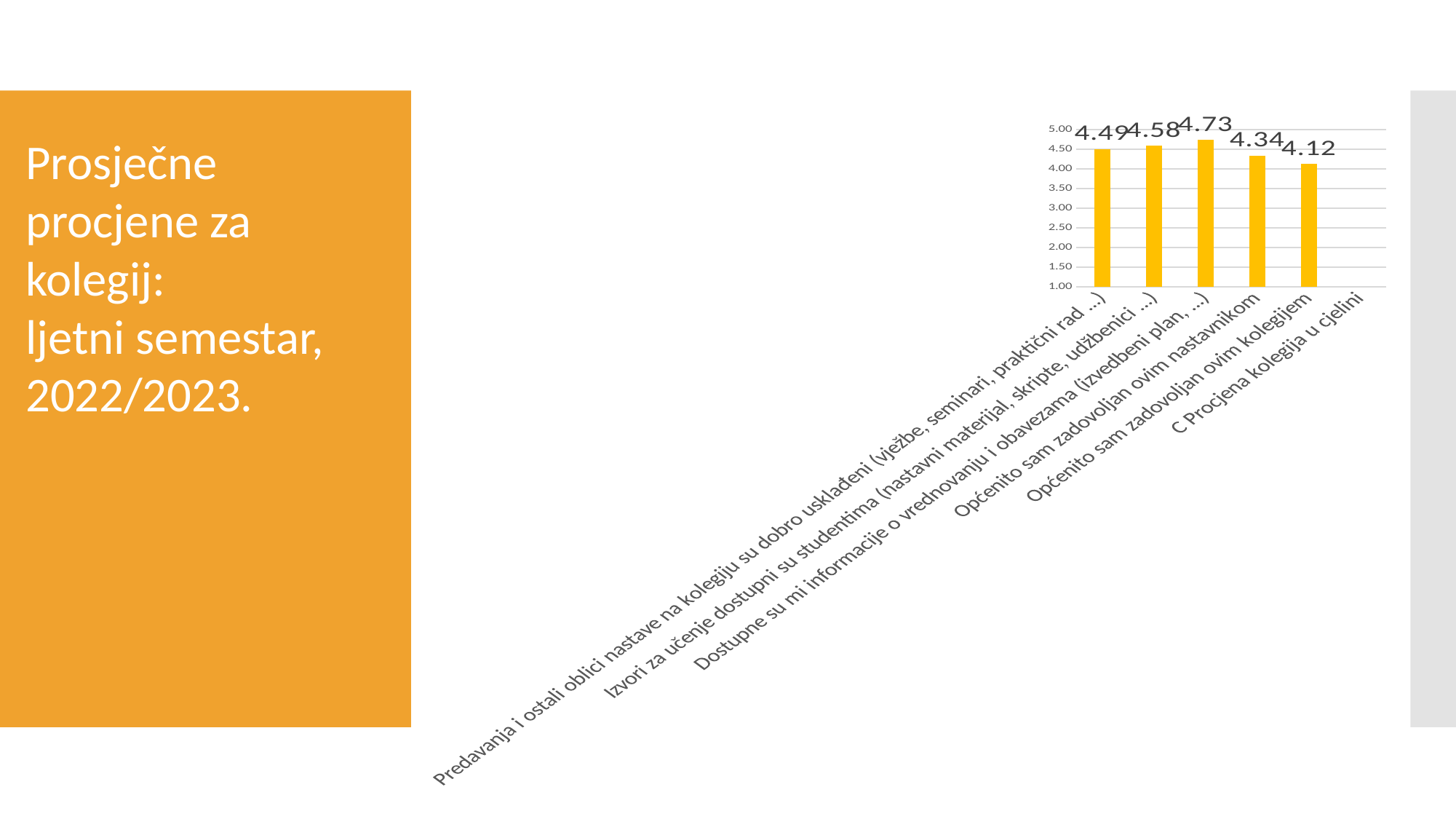
Which is larger: the value for "Predavanja i ostali oblici nastave na kolegiju su dobro usklađeni (vježbe, seminari, praktični rad ...)" or for "Općenito sam zadovoljan ovim nastavnikom"? Predavanja i ostali oblici nastave na kolegiju su dobro usklađeni (vježbe, seminari, praktični rad ...) Which category has the highest value? Dostupne su mi informacije o vrednovanju i obavezama (izvedbeni plan, ...) What is the value for "Izvori za učenje dostupni su studentima (nastavni materijal, skripte, udžbenici ...)"? 4.58 What is the value for "Općenito sam zadovoljan ovim kolegijem"? 4.12 Which category has the lowest value among the plotted bars? Općenito sam zadovoljan ovim kolegijem What is the maximum value shown on the vertical axis? 5.00 How many bars are plotted in the chart? 5 What is the difference between the highest value (4.73) and the lowest value (4.12)? 0.61 Is the value for "Općenito sam zadovoljan ovim kolegijem" greater or less than 4.50? less What is the value for "Dostupne su mi informacije o vrednovanju i obavezama (izvedbeni plan, ...)"? 4.73 What is the value for "Općenito sam zadovoljan ovim nastavnikom"? 4.34 What kind of chart is shown on the slide? bar chart